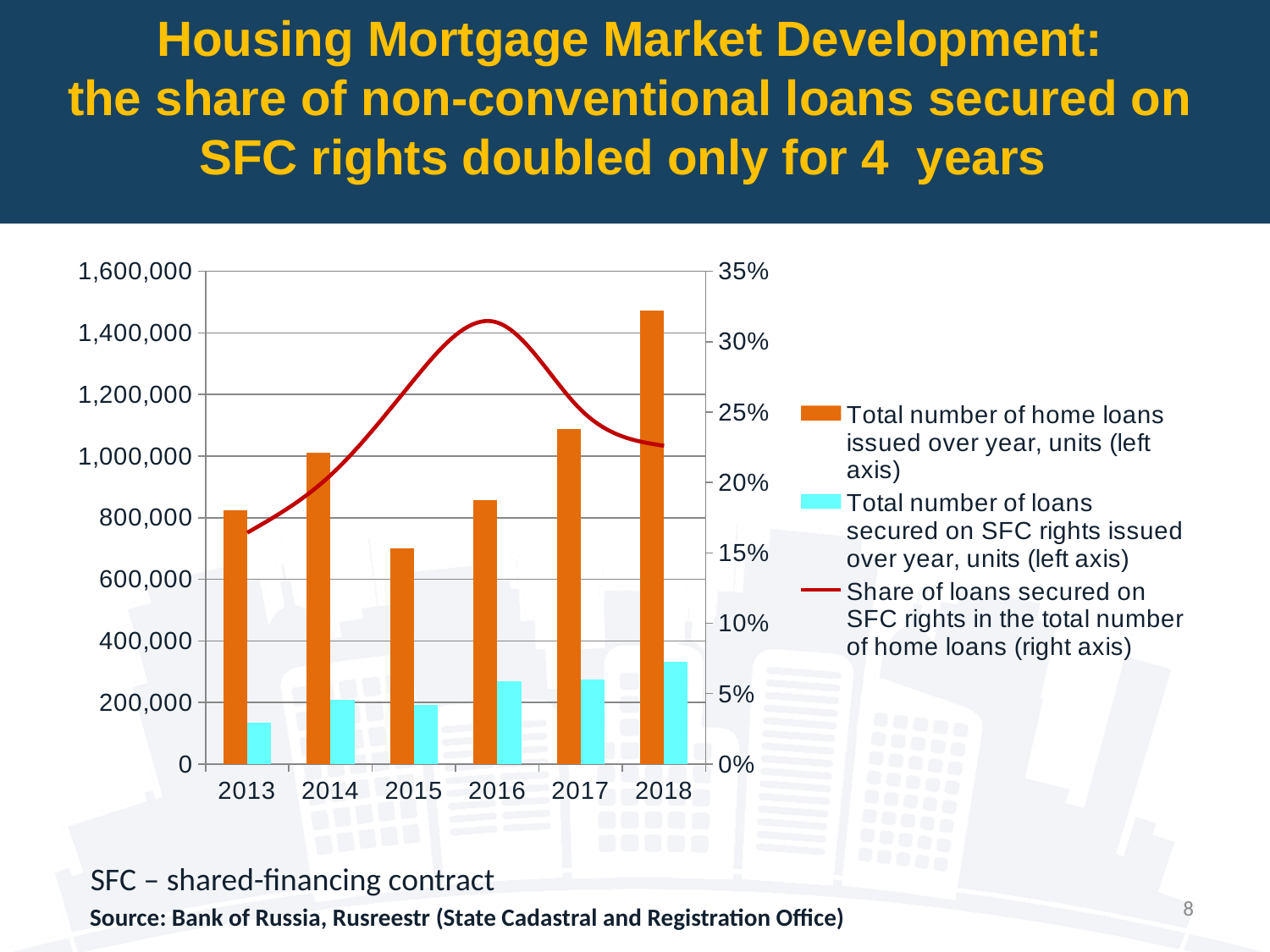
Is the total number of home loans issued in 2018 greater or less than 1,400,000? greater Is the share of loans secured on SFC rights in 2016 greater or less than 30%? greater In which year is the total number of loans secured on SFC rights the highest? 2018 Which year had more home loans issued in total, 2014 or 2015? 2014 How many series does the legend list? 3 In which year is the total number of loans secured on SFC rights the lowest? 2013 What kind of chart is shown on the slide? bar chart with a line How many years are shown on the x axis? 6 In which year is the total number of home loans issued over year the highest? 2018 In which year does the share of loans secured on SFC rights reach its peak? 2016 In which year is the total number of home loans issued over year the lowest? 2015 Is the total number of home loans issued in 2015 greater or less than 800,000? less